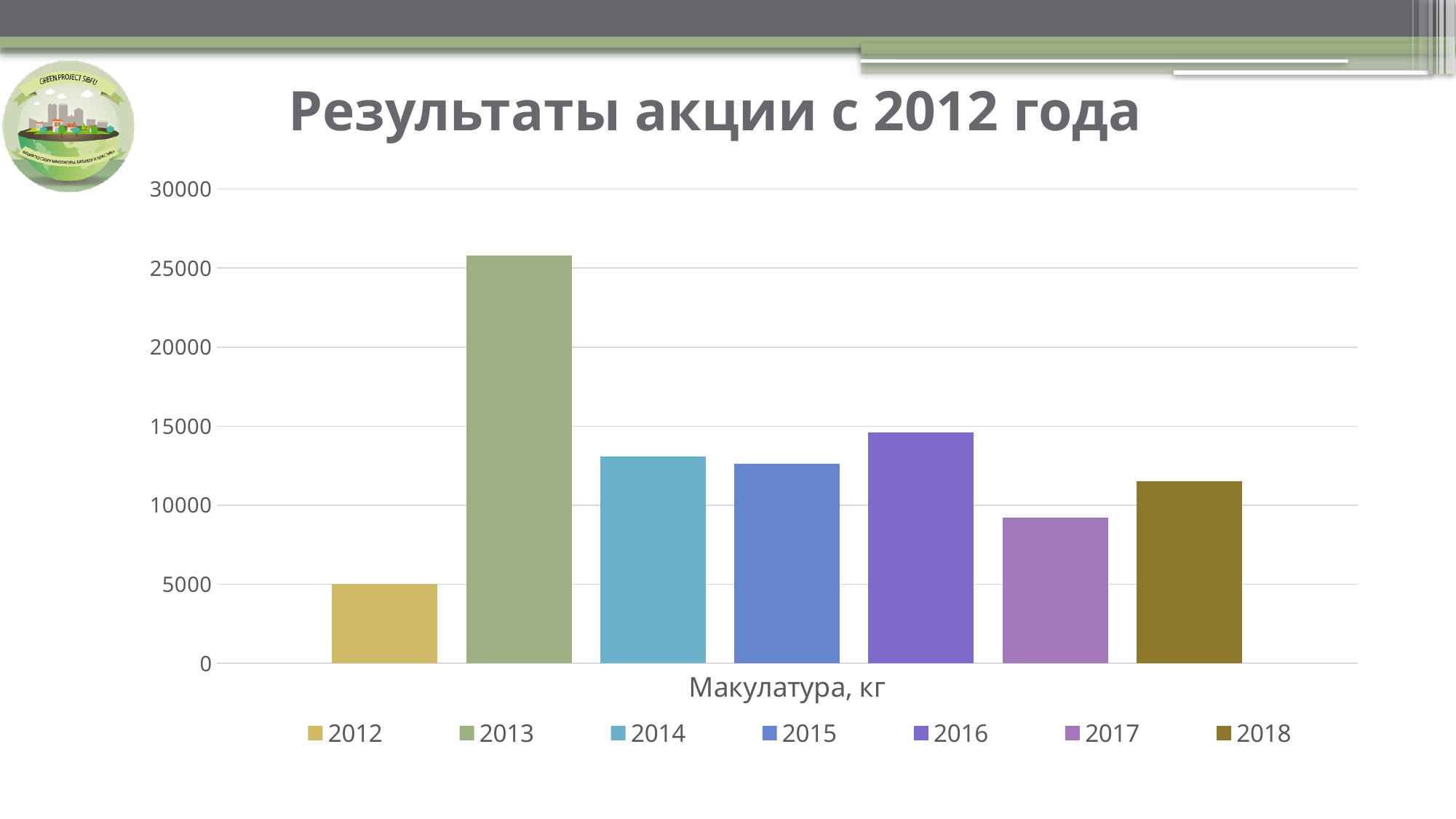
How many series does the legend list? 7 Which year has the lowest bar? 2012 Is the value for 2014 greater or less than 15000? less Which year has the highest bar? 2013 Which is larger, the value for 2017 or the value for 2018? 2018 What is the title of the slide? Результаты акции с 2012 года Which is larger, the value for 2016 or the value for 2014? 2016 What kind of chart is shown on the slide? bar chart Is the value for 2015 greater or less than 10000? greater Is the value for 2013 greater or less than 25000? greater